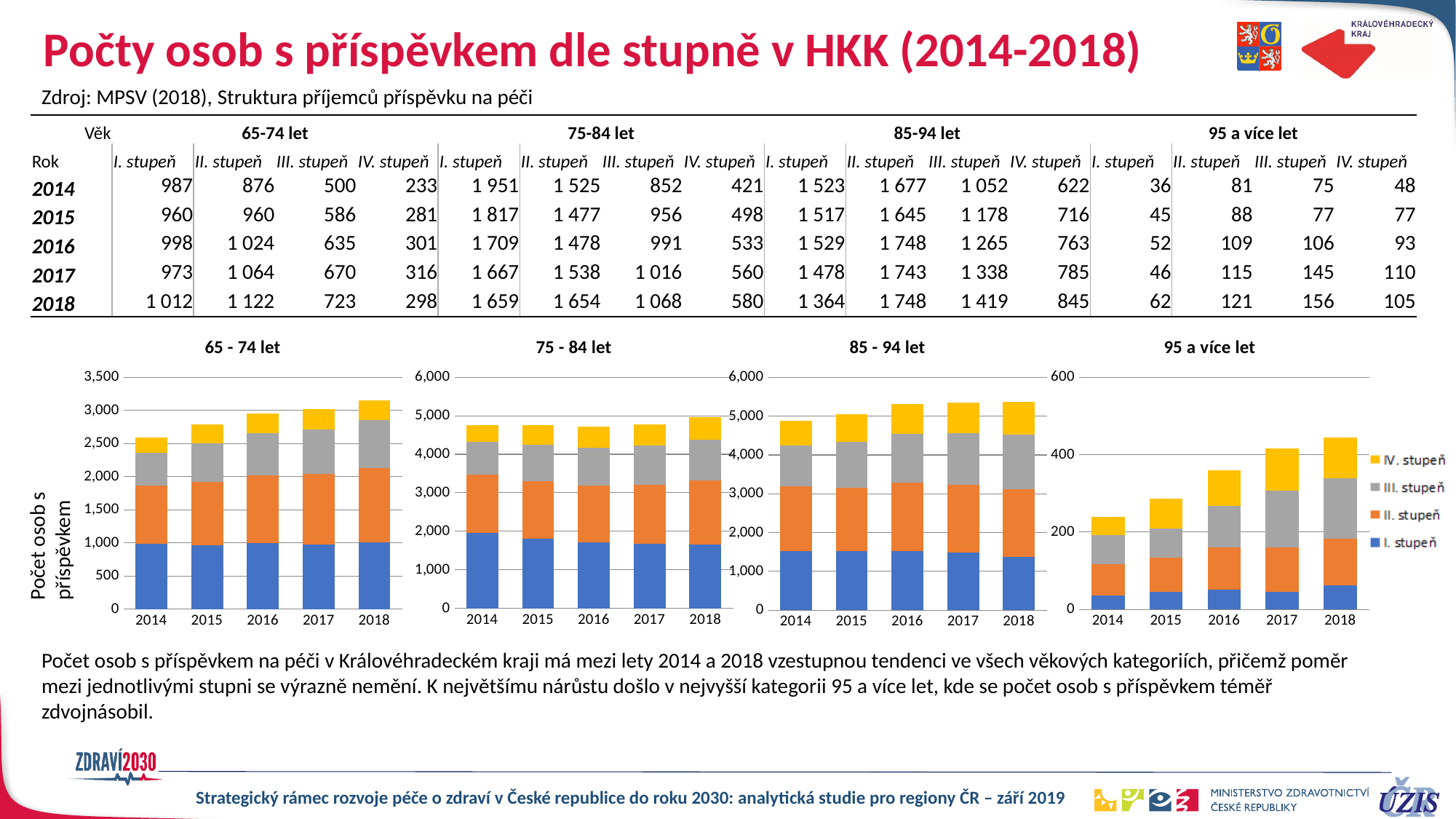
In the '95 a více let' chart, which year has the tallest stacked bar? 2018 In the '65 - 74 let' chart, is the total of the 2018 bar greater or less than 3,000? greater In the '95 a více let' chart, do the stacked bar totals rise or fall from 2014 to 2018? rise According to the table, what is the total of the 2018 stacked bar in the '95 a více let' chart (sum of I.–IV. stupeň)? 444 In the '65 - 74 let' chart, which year has the tallest stacked bar? 2018 Which colour represents 'I. stupeň' in the charts' legend? blue In the '65 - 74 let' chart, which bar is taller, 2014 or 2018? 2018 How many years are shown on the x axis of the '95 a více let' chart? 5 According to the table, what is the difference between IV. stupeň in 2018 and 2014 for the '95 a více let' group? 57 How many series does the legend list for the charts? 4 In the '75 - 84 let' chart, is the total of the 2014 bar greater or less than 5,000? less What kind of chart is used for the '65 - 74 let' panel? stacked bar chart